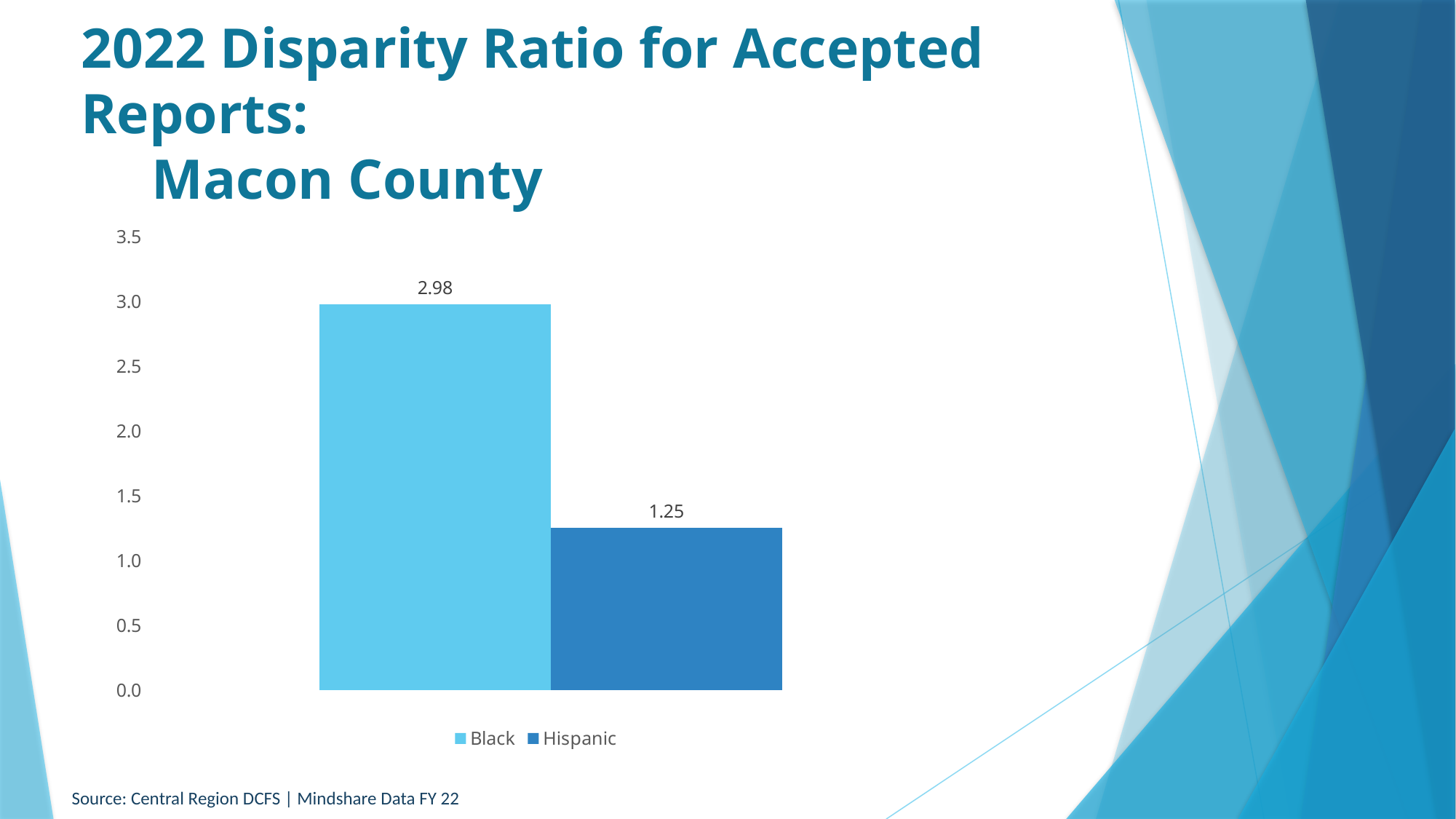
What is the disparity ratio for Black? 2.98 Which group has the lower disparity ratio? Hispanic What is the difference between the Black and Hispanic disparity ratios? 1.73 Which group has the higher disparity ratio? Black What kind of chart is shown on the slide? bar chart What is the highest value shown on the vertical axis? 3.5 What is the disparity ratio for Hispanic? 1.25 Is the value for Hispanic greater or less than 1.5? less Is the value for Black greater or less than 2.5? greater How many bars are plotted in the chart? 2 How many series does the legend list? 2 Is the disparity ratio for Black larger or smaller than the ratio for Hispanic? larger